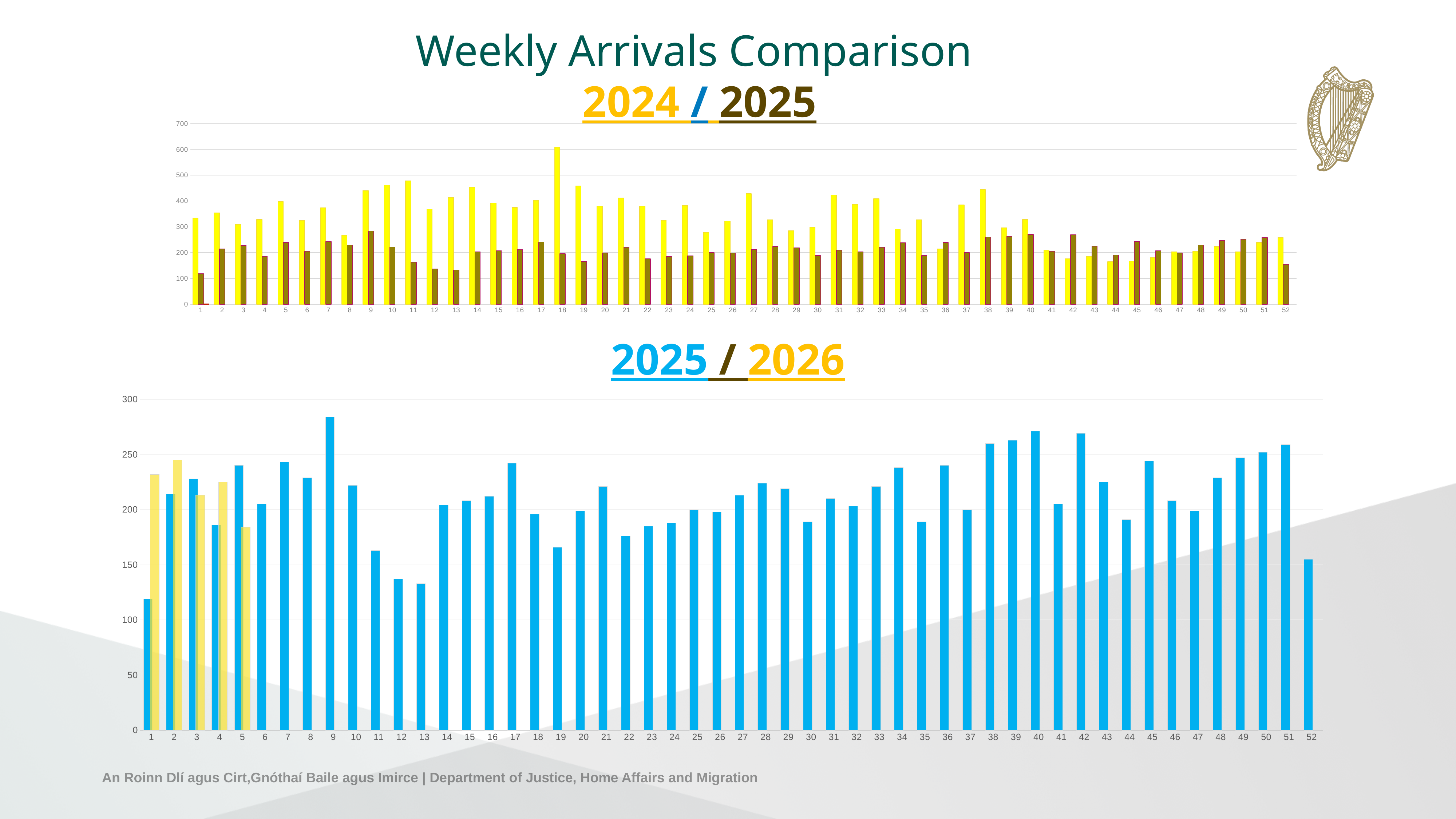
In the top chart (2024 / 2025), is the 2024 value for week 18 greater or less than 500? greater How many weeks are shown on the x axis of the bottom chart (2025 / 2026)? 52 What is the main title of the slide above the charts? Weekly Arrivals Comparison In the bottom chart (2025 / 2026), which is larger for week 2: the 2025 value or the 2026 value? 2026 In the bottom chart (2025 / 2026), is the 2025 value for week 9 greater or less than 250? greater In the bottom chart (2025 / 2026), which is larger for week 5: the 2025 value or the 2026 value? 2025 What kind of chart is the bottom chart titled 2025 / 2026? bar chart In the bottom chart (2025 / 2026), is the 2025 value for week 52 greater or less than 200? less In the top chart (2024 / 2025), which week has the highest 2024 value? 18 In the bottom chart (2025 / 2026), which week has the lowest 2025 value? 1 In the bottom chart (2025 / 2026), which week has the highest 2025 value? 9